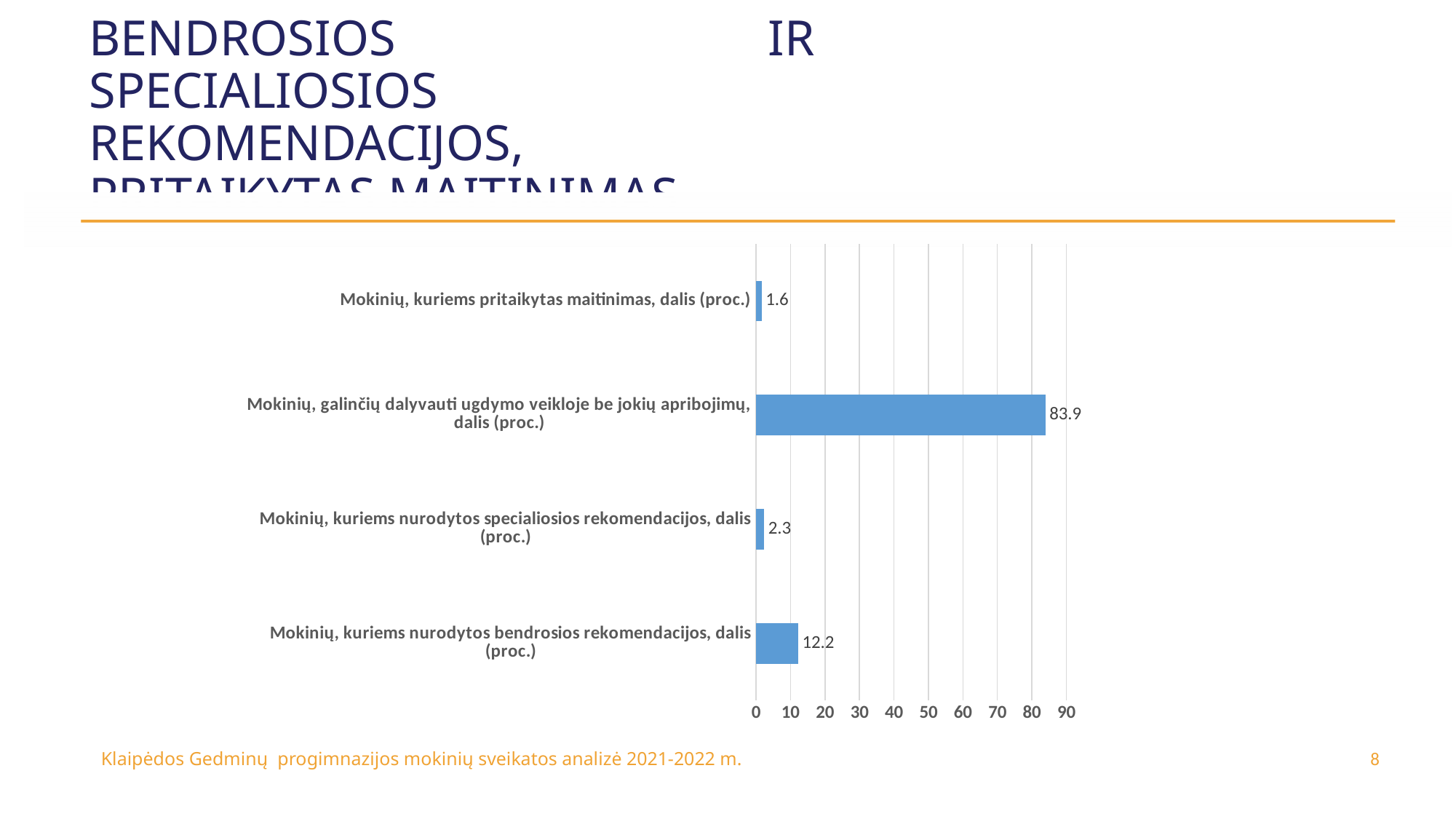
What is the value for 'Mokinių, kuriems nurodytos specialiosios rekomendacijos, dalis (proc.)'? 2.3 Which is larger: the value for 'Mokinių, kuriems nurodytos specialiosios rekomendacijos, dalis (proc.)' or the value for 'Mokinių, kuriems pritaikytas maitinimas, dalis (proc.)'? Mokinių, kuriems nurodytos specialiosios rekomendacijos, dalis (proc.) What is the value for 'Mokinių, galinčių dalyvauti ugdymo veikloje be jokių apribojimų, dalis (proc.)'? 83.9 Which category has the highest value? Mokinių, galinčių dalyvauti ugdymo veikloje be jokių apribojimų, dalis (proc.) Which category has the lowest value? Mokinių, kuriems pritaikytas maitinimas, dalis (proc.) What is the difference between the value for 'Mokinių, kuriems nurodytos bendrosios rekomendacijos, dalis (proc.)' and the value for 'Mokinių, kuriems nurodytos specialiosios rekomendacijos, dalis (proc.)'? 9.9 What is the highest value shown on the horizontal axis of the chart? 90 What is the value for 'Mokinių, kuriems pritaikytas maitinimas, dalis (proc.)'? 1.6 What kind of chart is shown on the slide? bar chart What is the value for 'Mokinių, kuriems nurodytos bendrosios rekomendacijos, dalis (proc.)'? 12.2 How many categories are shown in the chart? 4 Is the value for 'Mokinių, galinčių dalyvauti ugdymo veikloje be jokių apribojimų, dalis (proc.)' greater or less than 80? greater